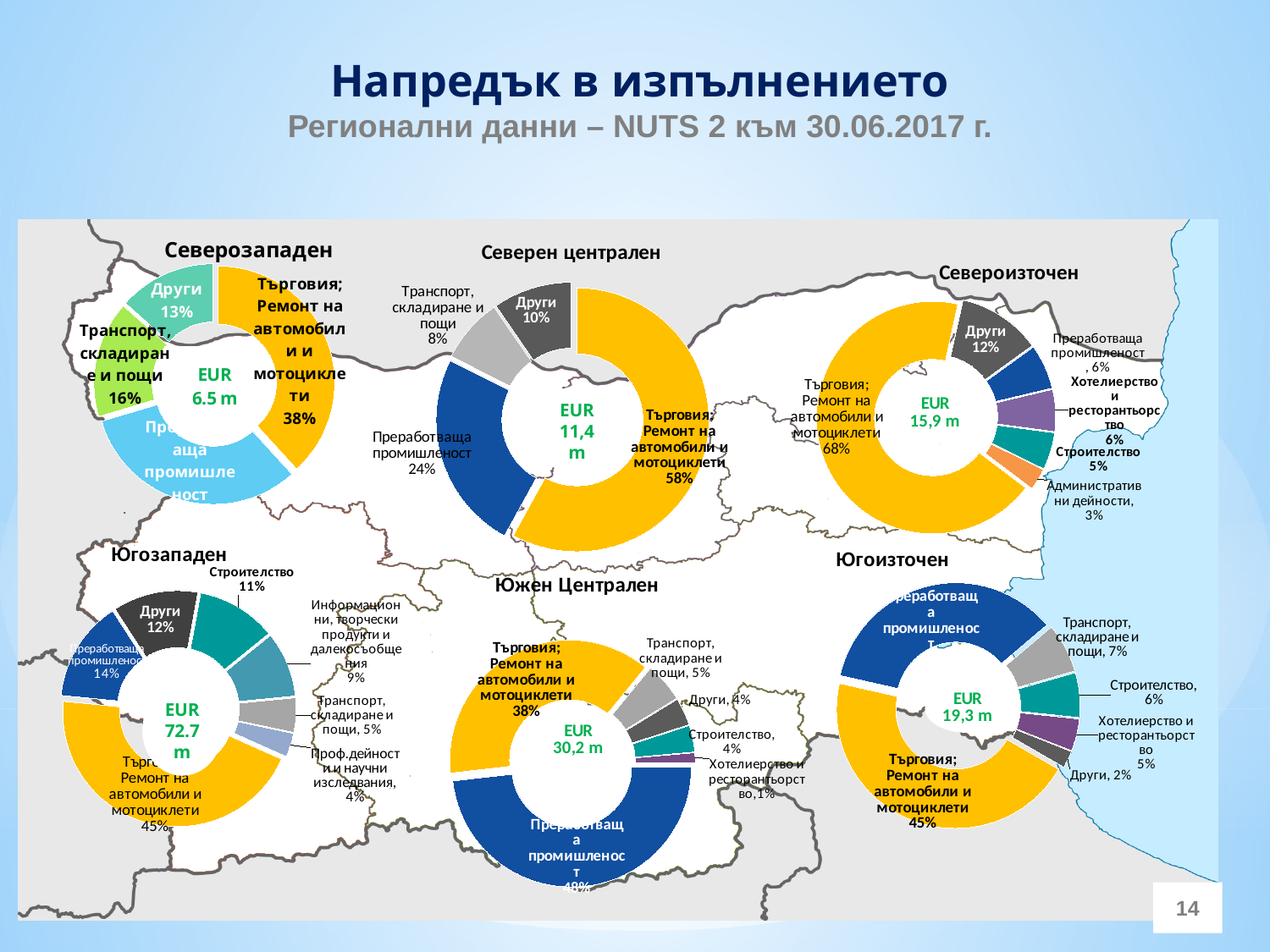
In the Северен централен chart, which category has the largest share? Търговия; Ремонт на автомобили и мотоциклети In the Североизточен chart, what is the difference between the share of Търговия; Ремонт на автомобили и мотоциклети and the share of Други? 56% In the Югозападен chart, which is larger: the share of Строителство or the share of Преработваща промишленост? Преработваща промишленост In the Югоизточен chart, what share does Транспорт, складиране и пощи have? 7% In the Северозападен chart, what is the total amount shown in the centre? EUR 6.5 m What kind of chart is used for each region on the slide? Donut (pie) chart In the Южен Централен chart, what share does Хотелиерство и ресторантьорство have? 1% How many regional charts are shown on the slide? 6 In the Северозападен chart, what share does Търговия; Ремонт на автомобили и мотоциклети have? 38% In the Югозападен chart, what is the total amount shown in the centre? EUR 72.7 m In the Североизточен chart, which category has the smallest share? Административни дейности